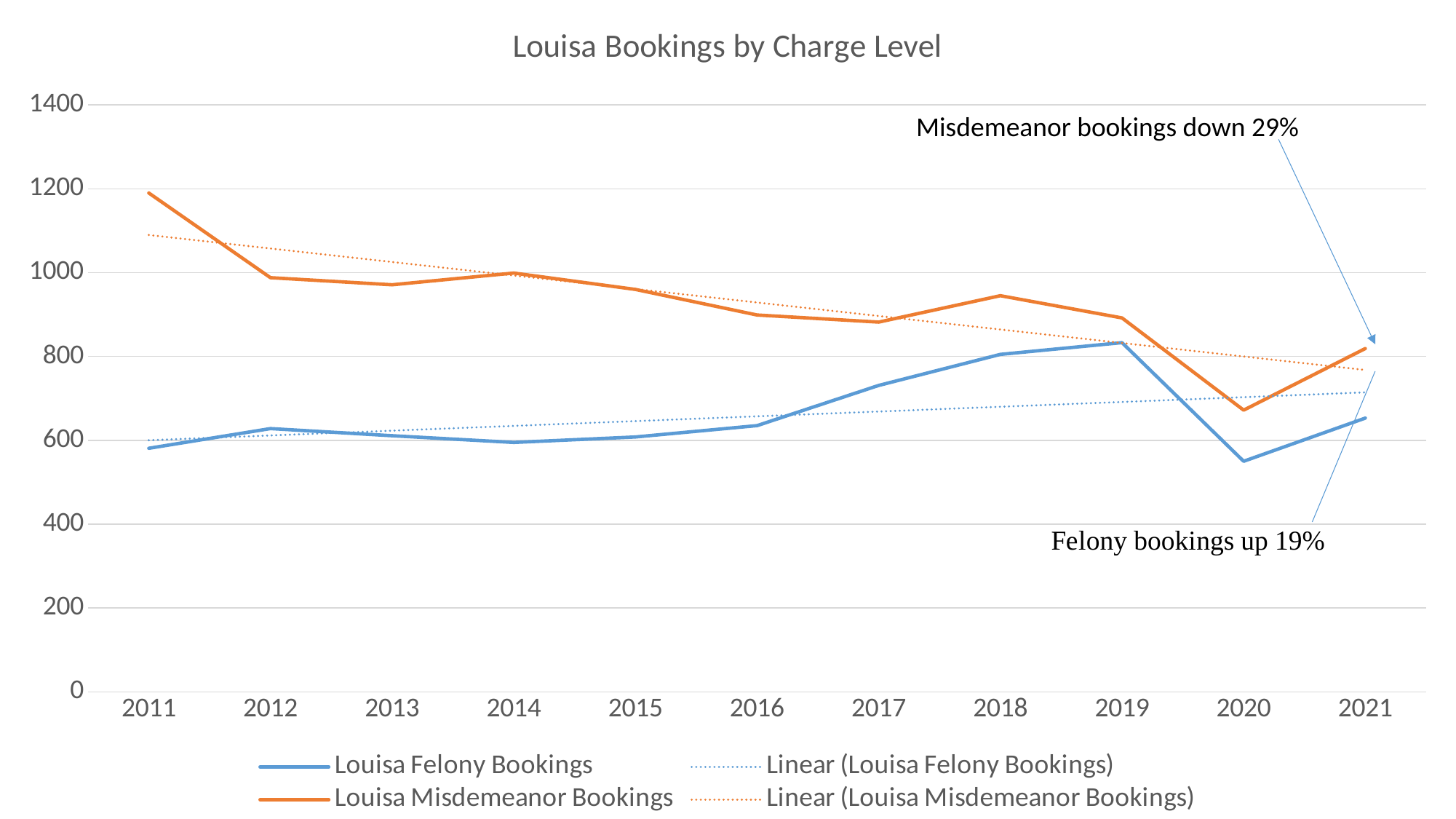
In which year were Louisa Misdemeanor Bookings lowest? 2020 In which year were Louisa Felony Bookings highest? 2019 What is the title of the chart? Louisa Bookings by Charge Level How many years are shown along the x axis? 11 What kind of chart is shown on the slide? line chart How many entries does the chart's legend list? 4 In which year were Louisa Misdemeanor Bookings highest? 2011 Does the dotted linear trend line for Louisa Misdemeanor Bookings rise or fall from 2011 to 2021? fall In 2021, which series has the larger value: Louisa Felony Bookings or Louisa Misdemeanor Bookings? Louisa Misdemeanor Bookings In which year were Louisa Felony Bookings lowest? 2020 Is the value for Louisa Misdemeanor Bookings in 2011 greater or less than 1000? greater Is the value for Louisa Felony Bookings in 2020 greater or less than 600? less